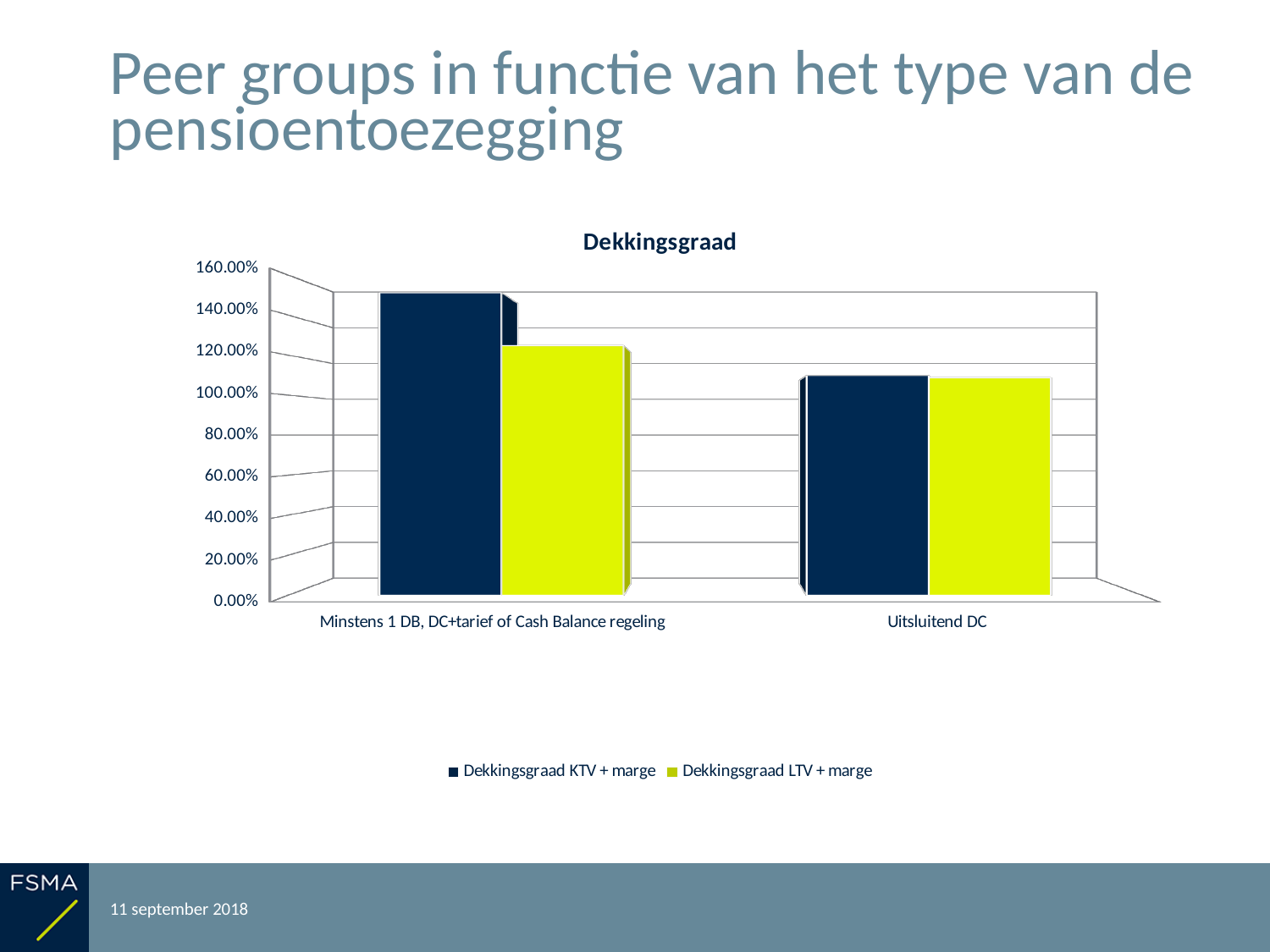
What is the title of the chart? Dekkingsgraad Which series is shown in yellow-green? Dekkingsgraad LTV + marge Is the value for Dekkingsgraad KTV + marge for 'Uitsluitend DC' greater or less than 100.00%? greater How many categories are shown on the x axis? 2 Which category has the higher value for Dekkingsgraad KTV + marge? Minstens 1 DB, DC+tarief of Cash Balance regeling Do the values for Dekkingsgraad LTV + marge rise or fall from the first category to the second? fall Is the value for Dekkingsgraad KTV + marge for 'Minstens 1 DB, DC+tarief of Cash Balance regeling' greater or less than 140.00%? greater Is the value for Dekkingsgraad LTV + marge for 'Uitsluitend DC' greater or less than 120.00%? less How many series does the legend list? 2 For 'Minstens 1 DB, DC+tarief of Cash Balance regeling', which is larger: Dekkingsgraad KTV + marge or Dekkingsgraad LTV + marge? Dekkingsgraad KTV + marge What kind of chart is shown on the slide? bar chart